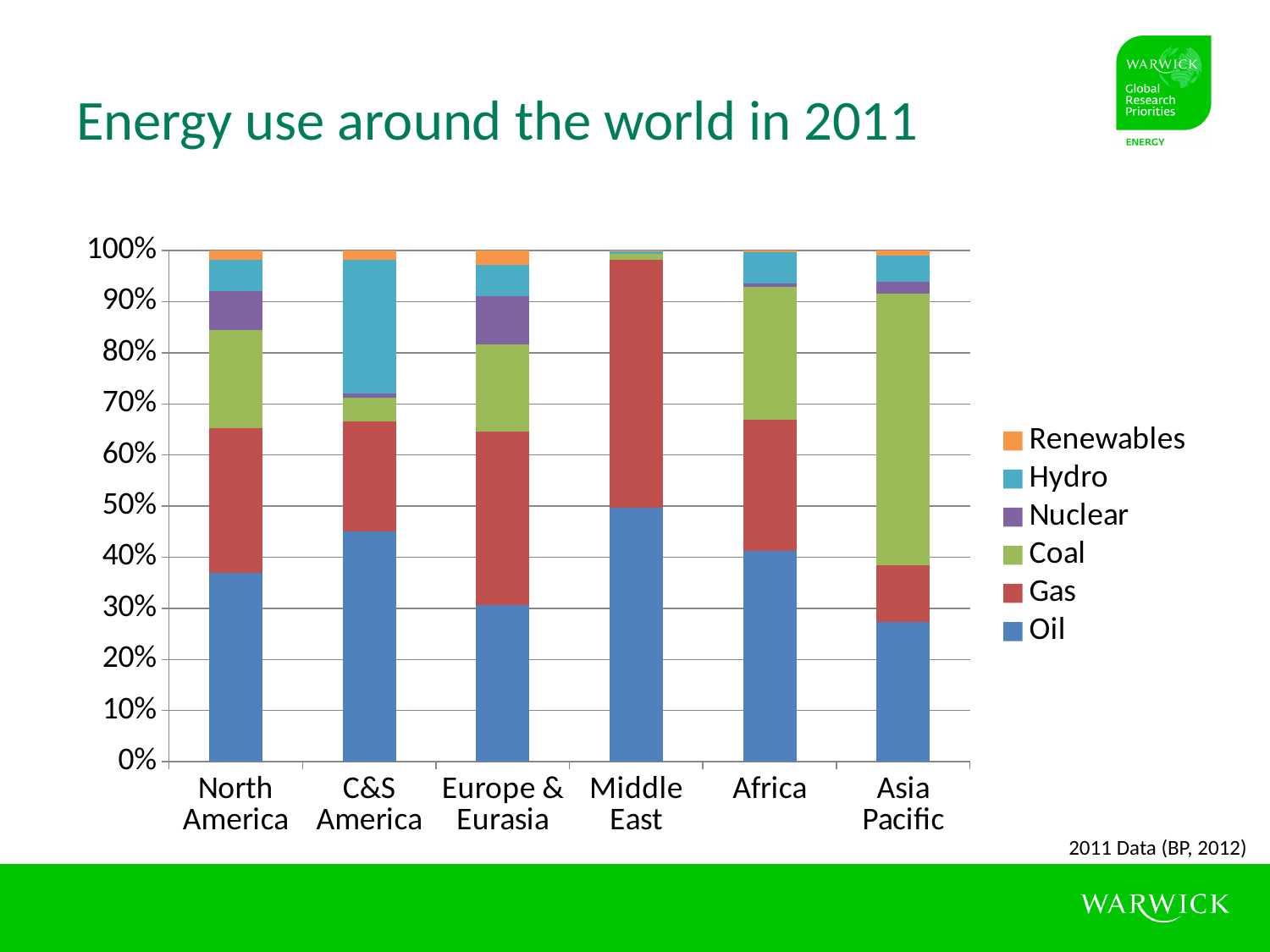
Which has the larger Hydro share, C&S America or North America? C&S America How many energy sources does the legend list? 6 Is the Oil share for Asia Pacific greater or less than 30%? less How many regions are shown on the x axis of the chart? 6 Which region has the largest Coal share of its energy use? Asia Pacific What kind of chart is shown on the slide? Stacked bar chart What does each stacked bar total? 100% Which region has the smallest Oil share of its energy use? Asia Pacific Which region has the largest Oil share of its energy use? Middle East What is the title of the chart? Energy use around the world in 2011 Is the Oil share for North America greater or less than 40%? less Which region has the largest Hydro share of its energy use? C&S America